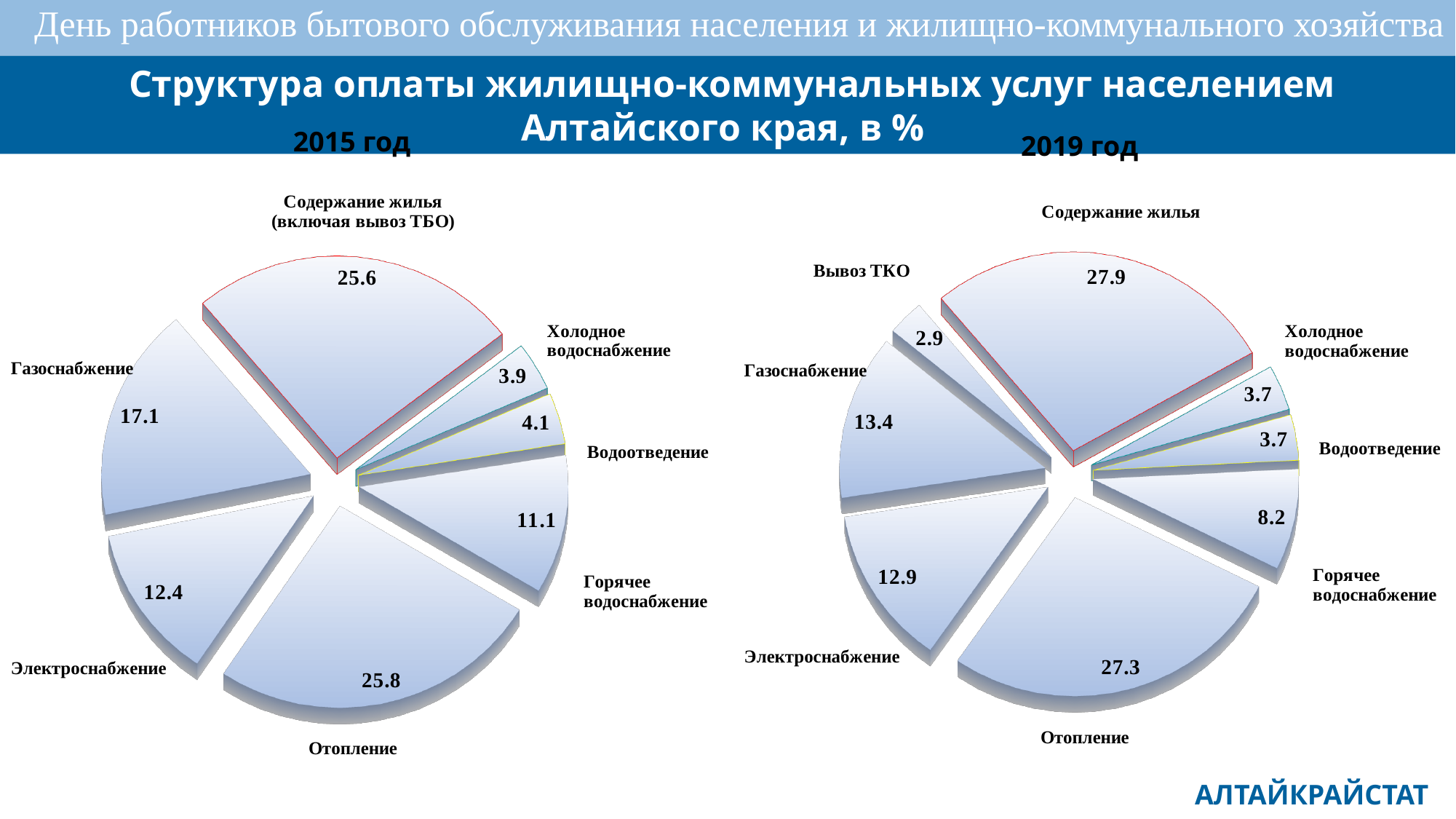
In the 2015 год chart, which category has the smallest share? Холодное водоснабжение What is the difference between the value for Отопление in the 2019 год chart and in the 2015 год chart? 1.5 In the 2015 год chart, what is the value for Газоснабжение? 17.1 In the 2019 год chart, which category has the largest share? Содержание жилья In the 2019 год chart, which is larger: Газоснабжение or Электроснабжение? Газоснабжение In the 2019 год chart, what is the value for Вывоз ТКО? 2.9 What type of chart is used for the 2015 год data? pie chart In the 2019 год chart, what is the value for Горячее водоснабжение? 8.2 In the 2019 год chart, which category has the smallest share? Вывоз ТКО In the 2015 год chart, which category has the largest share? Отопление How many categories are shown in the 2019 год chart? 8 How many categories are shown in the 2015 год chart? 7